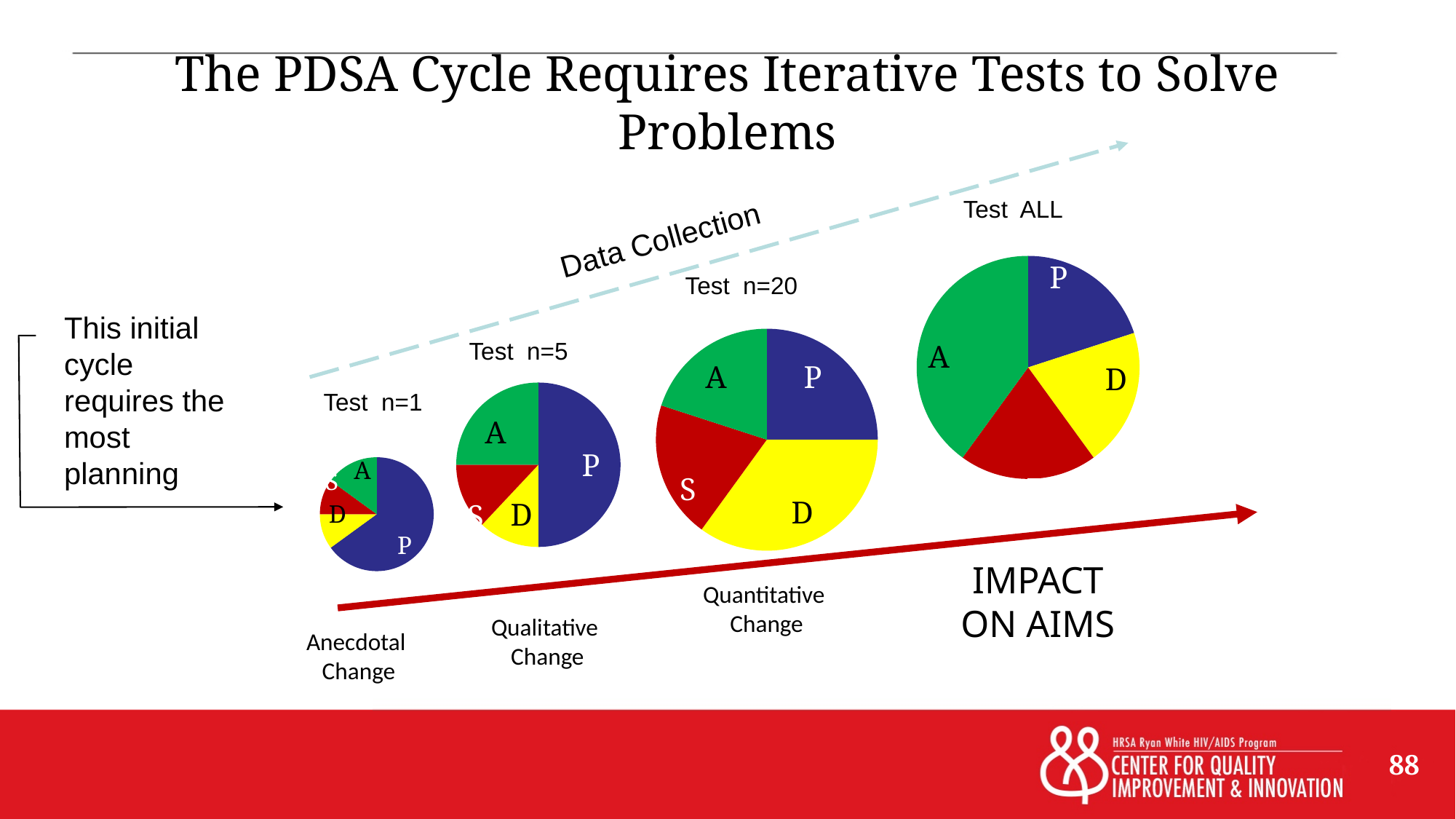
In the "Test n=20" pie chart, which slice is the largest? D What label appears above the largest pie chart on the right? Test ALL In the "Test ALL" pie chart, which slice is the largest? A In the "Test n=20" pie chart, which slice is larger, P or D? D In the "Test n=1" pie chart, which slice is the largest? P What colour is the P slice in the pie charts? Blue In the "Test n=20" pie chart, how many slices are there? 4 In the "Test n=1" pie chart, which slice is larger, P or A? P In the "Test ALL" pie chart, which slice is larger, A or P? A What kind of charts are shown on the slide? Pie charts How many pie charts are shown on the slide? 4